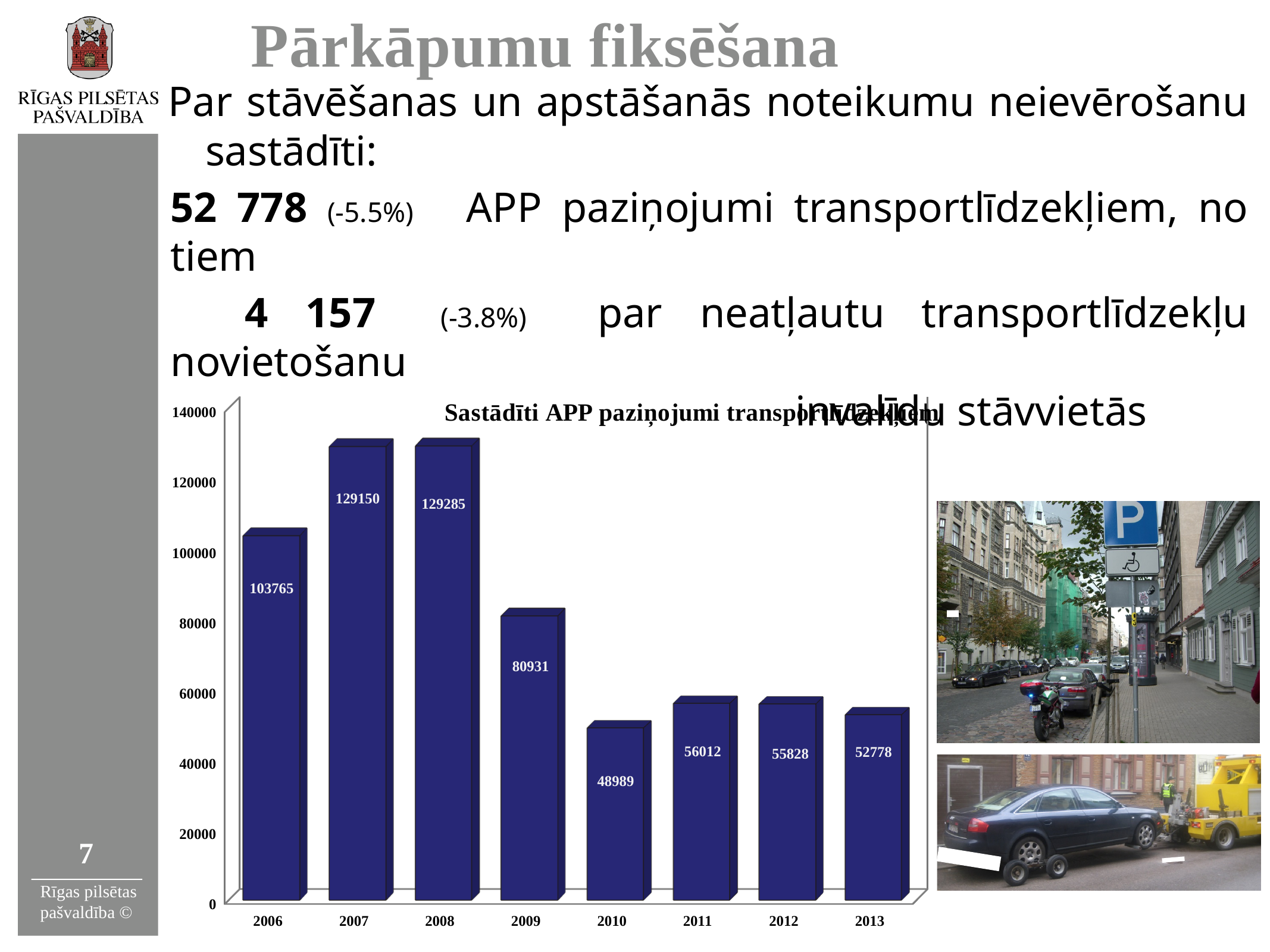
Do the values rise or fall from 2008 to 2010? fall What kind of chart is shown on the slide? bar chart Which is larger, the value for 2006 or the value for 2009? 2006 Is the value for 2010 greater or less than 60000? less Which year has the lowest value? 2010 What is the value for 2009? 80931 What is the difference between the values for 2006 and 2013? 50987 How many years are shown on the x axis? 8 What is the value for 2010? 48989 What is the value for 2006? 103765 What is the difference between the values for 2009 and 2010? 31942 What is the value for 2013? 52778